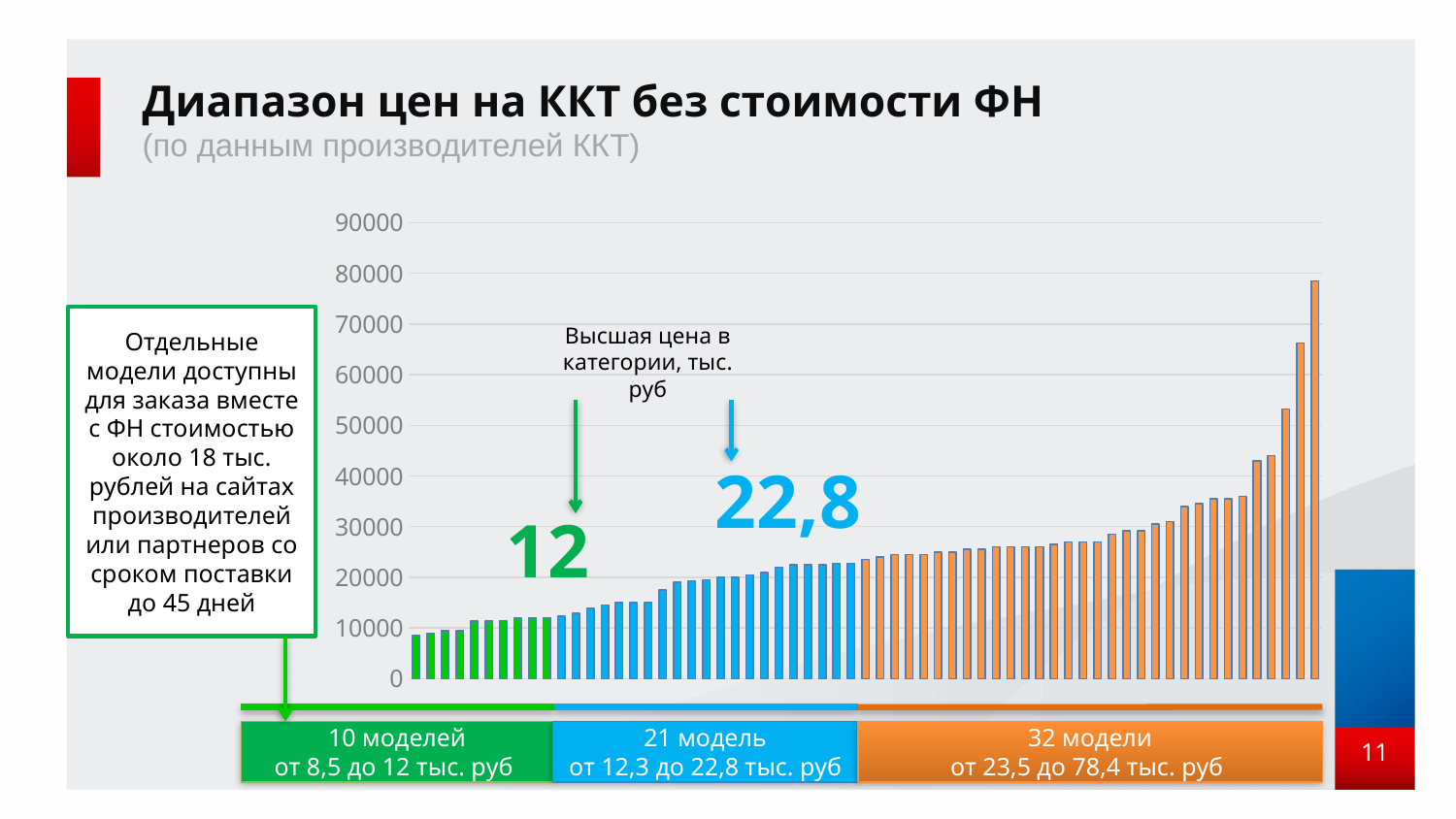
Do the bar values rise or fall from left to right along the x axis? Rise Is the value of the tallest bar on the chart greater or less than 70000? greater How many models are in the blue group? 21 What is the title of the chart on the slide? Диапазон цен на ККТ без стоимости ФН How many models are in the orange group? 32 What is the difference between the highest price in the blue category (22,8) and the highest price in the green category (12), in thousand rubles? 10,8 What is the highest price in the green category, in thousand rubles? 12 What is the highest price in the blue category, in thousand rubles? 22,8 How many models are in the green group (10 моделей)? 10 What kind of chart is shown on the slide? Bar chart What is the price range of the orange group of 32 models? от 23,5 до 78,4 тыс. руб